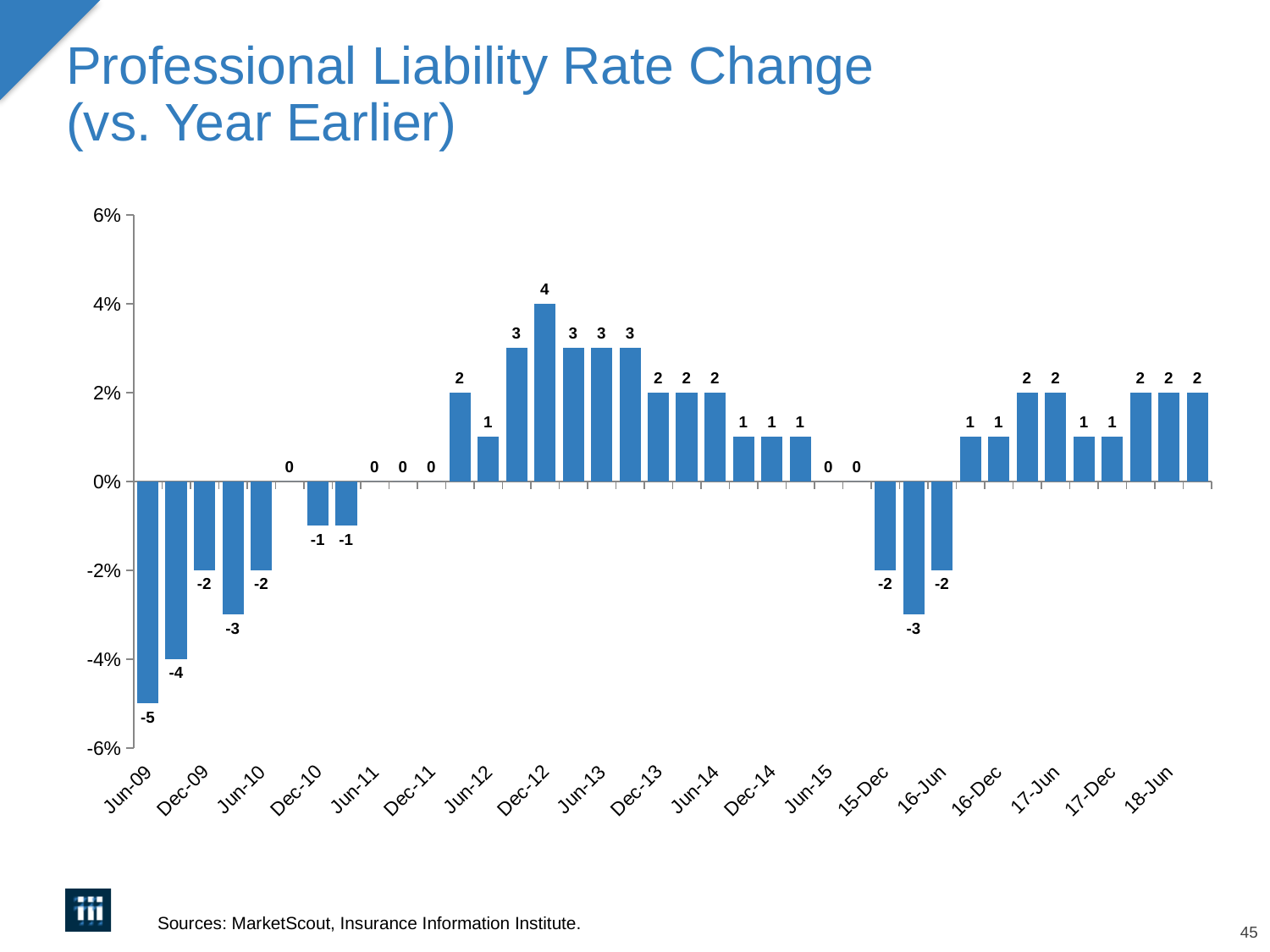
Is the value for Jun-09 greater or less than -4%? less How many bars are plotted in the chart? 38 What is the professional liability rate change for Jun-09? -5 What sources are cited for the chart? MarketScout, Insurance Information Institute What kind of chart is shown on the slide? Bar chart What is the professional liability rate change for Dec-12? 4 What is the difference between the highest value (4) and the lowest value (-5) in the chart? 9 What is the highest rate change value shown in the chart? 4 What is the title of the chart on the slide? Professional Liability Rate Change (vs. Year Earlier) What is the lowest rate change value shown in the chart? -5 Which is larger, the rate change for Jun-09 or for Dec-12? Dec-12 Do the values generally rise or fall from Jun-09 to Dec-12? Rise